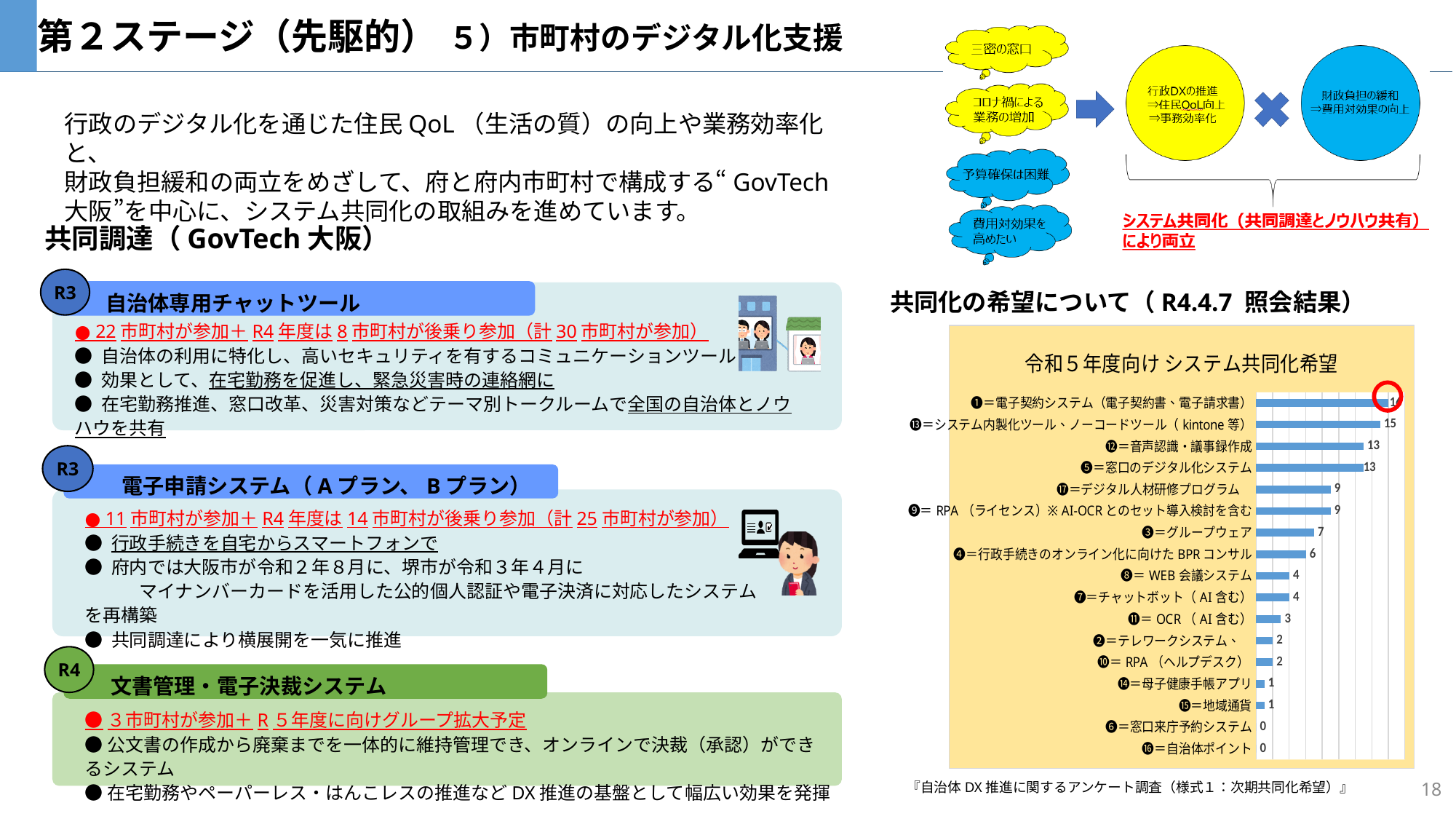
In the 令和５年度向け システム共同化希望 chart, which is larger: ❹＝行政手続きのオンライン化に向けたBPRコンサル or ❽＝WEB会議システム? ❹＝行政手続きのオンライン化に向けたBPRコンサル In the 令和５年度向け システム共同化希望 chart, how many categories are listed? 17 In the 令和５年度向け システム共同化希望 chart, what is the value for ⓱＝デジタル人材研修プログラム? 9 In the 令和５年度向け システム共同化希望 chart, what is the value for ❸＝グループウェア? 7 In the 令和５年度向け システム共同化希望 chart, what is the difference between ⓭＝システム内製化ツール (15) and ⓬＝音声認識・議事録作成 (13)? 2 In the 令和５年度向け システム共同化希望 chart, what is the value for ❺＝窓口のデジタル化システム? 13 In the 令和５年度向け システム共同化希望 chart, how many categories have a value of 0? 2 In the 令和５年度向け システム共同化希望 chart, what is the value for ⓫＝OCR（AI含む）? 3 What is the title of the chart on the right side of the slide? 令和５年度向け システム共同化希望 In the 令和５年度向け システム共同化希望 chart, what is the value for ⓭＝システム内製化ツール、ノーコードツール（kintone等）? 15 In the 令和５年度向け システム共同化希望 chart, which category has the longest bar? ❶＝電子契約システム（電子契約書、電子請求書） What type of chart is shown under the heading 共同化の希望について（R4.4.7 照会結果）? bar chart